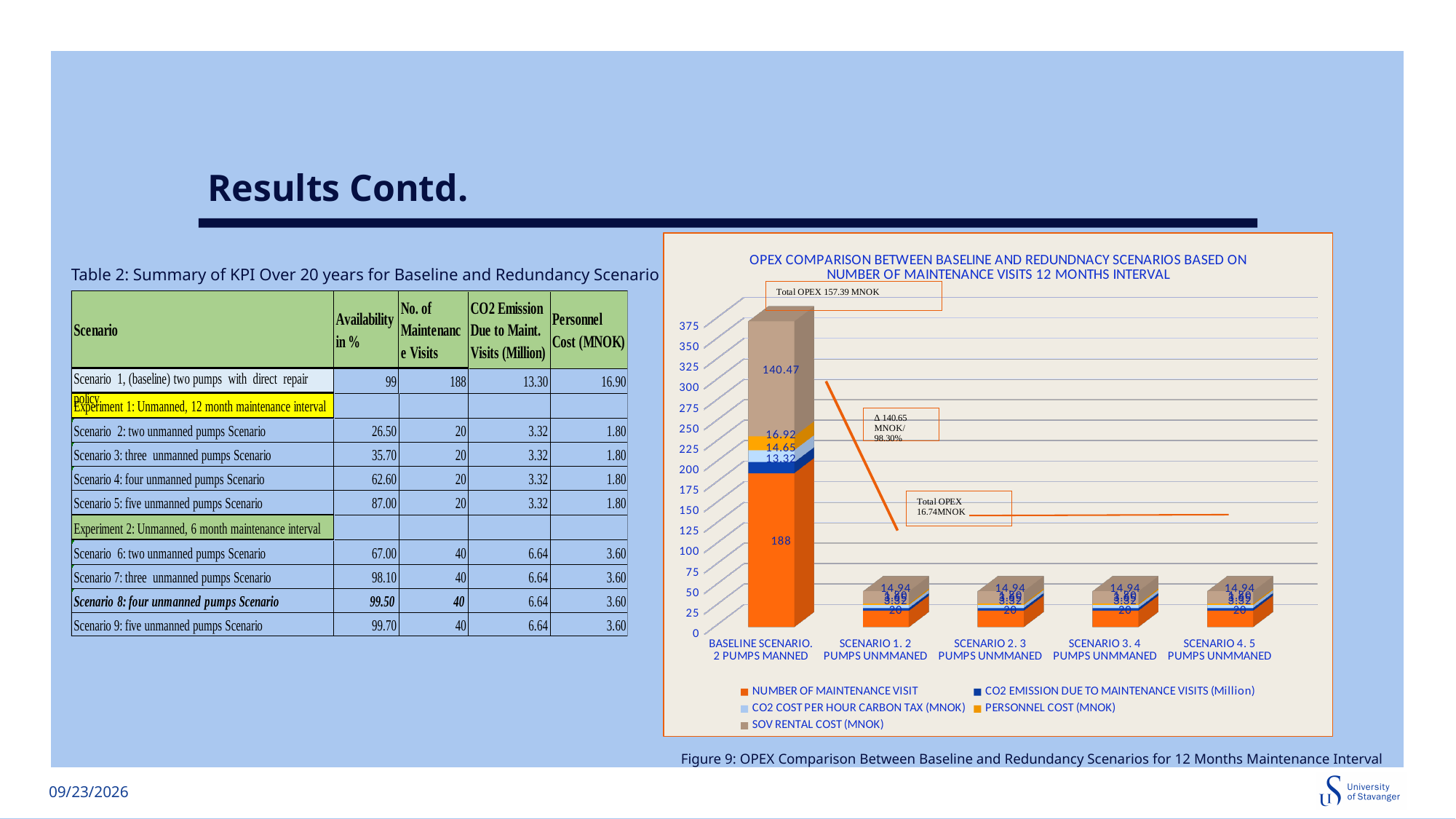
What is the SOV rental cost (MNOK) for Scenario 1, 2 pumps unmanned? 14.94 How many series does the chart legend list? 5 What is the difference in number of maintenance visits between the Baseline Scenario and Scenario 1, 2 pumps unmanned? 168 Is the total height of the Baseline Scenario bar greater or less than 350? greater How many scenario categories are plotted along the x axis of the chart? 5 What kind of chart is shown on the slide? Stacked bar chart What is the number of maintenance visits for the Baseline Scenario, 2 pumps manned? 188 What is the number of maintenance visits for Scenario 2, 3 pumps unmanned? 20 What is the SOV rental cost (MNOK) for the Baseline Scenario, 2 pumps manned? 140.47 What is the personnel cost (MNOK) for the Baseline Scenario, 2 pumps manned? 16.92 What is the CO2 emission due to maintenance visits (Million) for the Baseline Scenario, 2 pumps manned? 13.32 Which scenario has the tallest stacked bar in the chart? Baseline Scenario, 2 pumps manned